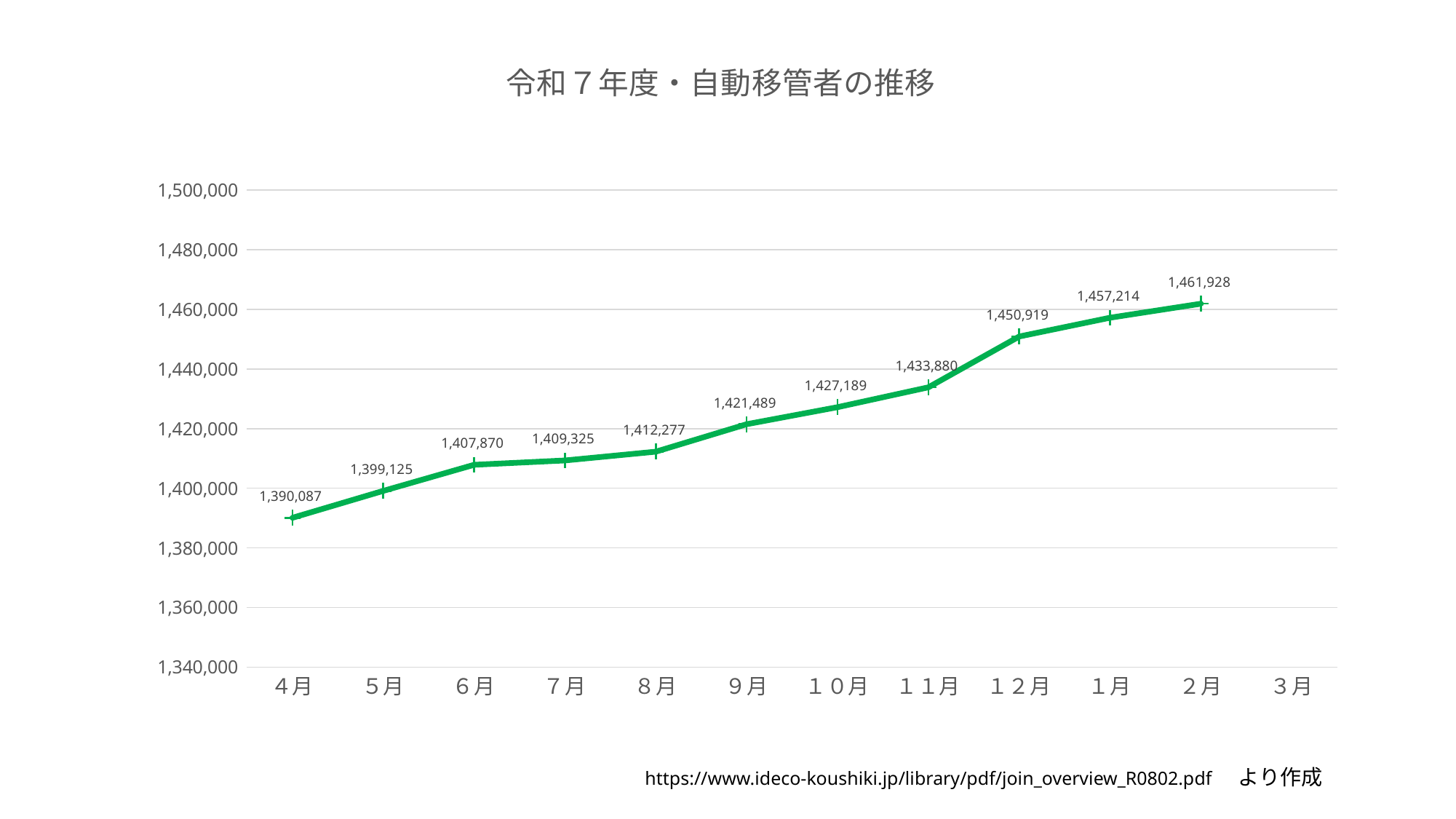
What type of chart is shown on the slide? line chart Do the values rise or fall from 4月 to 2月? rise What is the value for 9月? 1,421,489 Which month has the lowest value? 4月 Which month has the highest value? 2月 What is the value for 12月? 1,450,919 What is the difference between the values for 12月 and 11月? 17,039 What is the title of the chart? 令和７年度・自動移管者の推移 What is the value for 2月? 1,461,928 What is the value for 4月? 1,390,087 What is the difference between the values for 2月 and 4月? 71,841 Is the value for 12月 greater or less than 1,440,000? greater